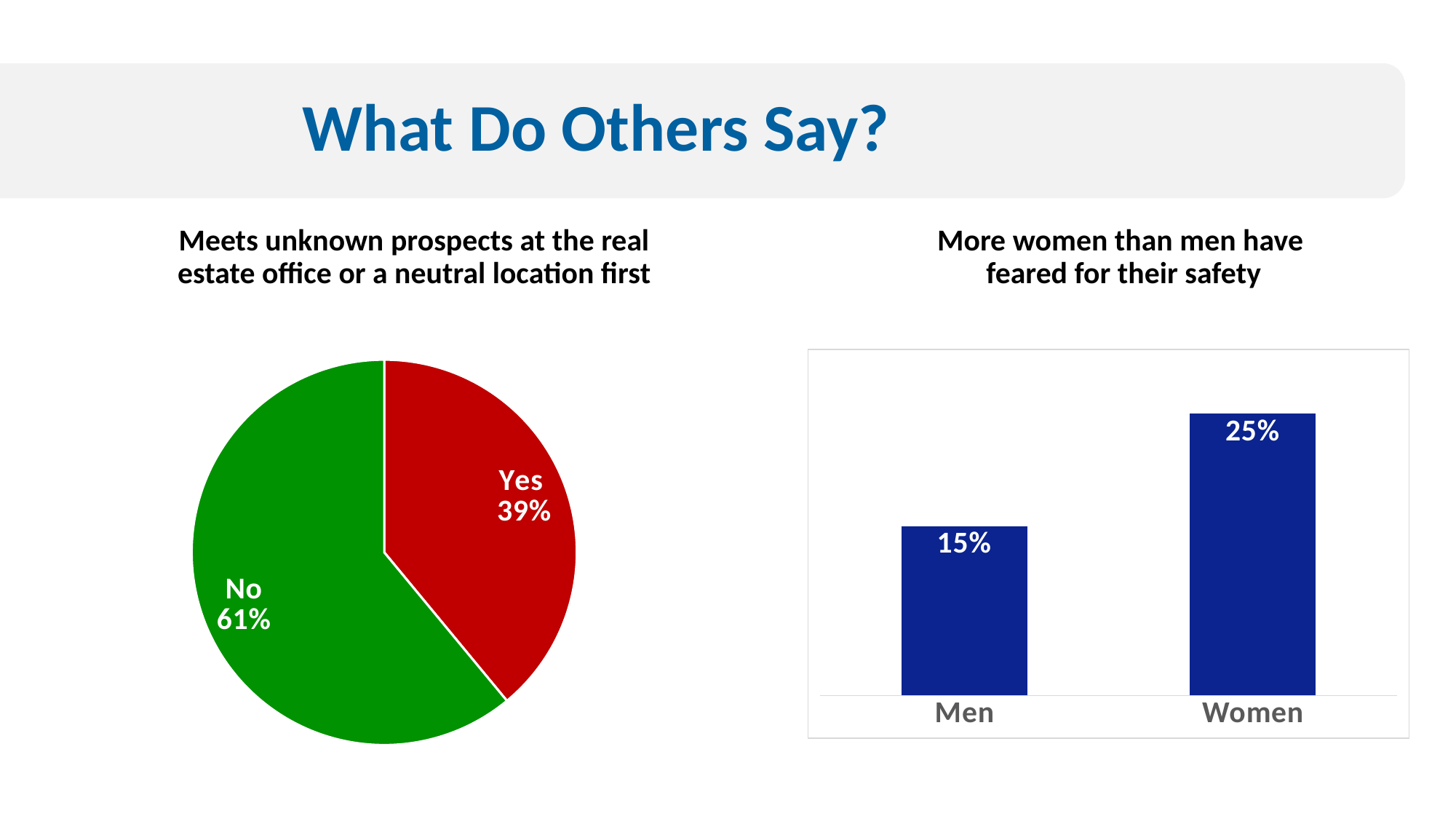
In the pie chart on the left, what colour is the No slice? Green In the chart on the right, what is the difference between the values for Women and Men? 10% In the pie chart on the left, what is the difference between the No and Yes shares? 22% In the chart on the right, what is the value for Women? 25% In the chart on the right, which category has the higher value? Women In the pie chart on the left, which slice is larger, Yes or No? No What type of chart is shown on the left of the slide? Pie chart In the pie chart on the left, what share of respondents answered Yes? 39% In the pie chart on the left, what share of respondents answered No? 61% What type of chart is shown on the right of the slide? Bar chart How many slices does the pie chart on the left have? 2 In the chart on the right, what is the value for Men? 15%